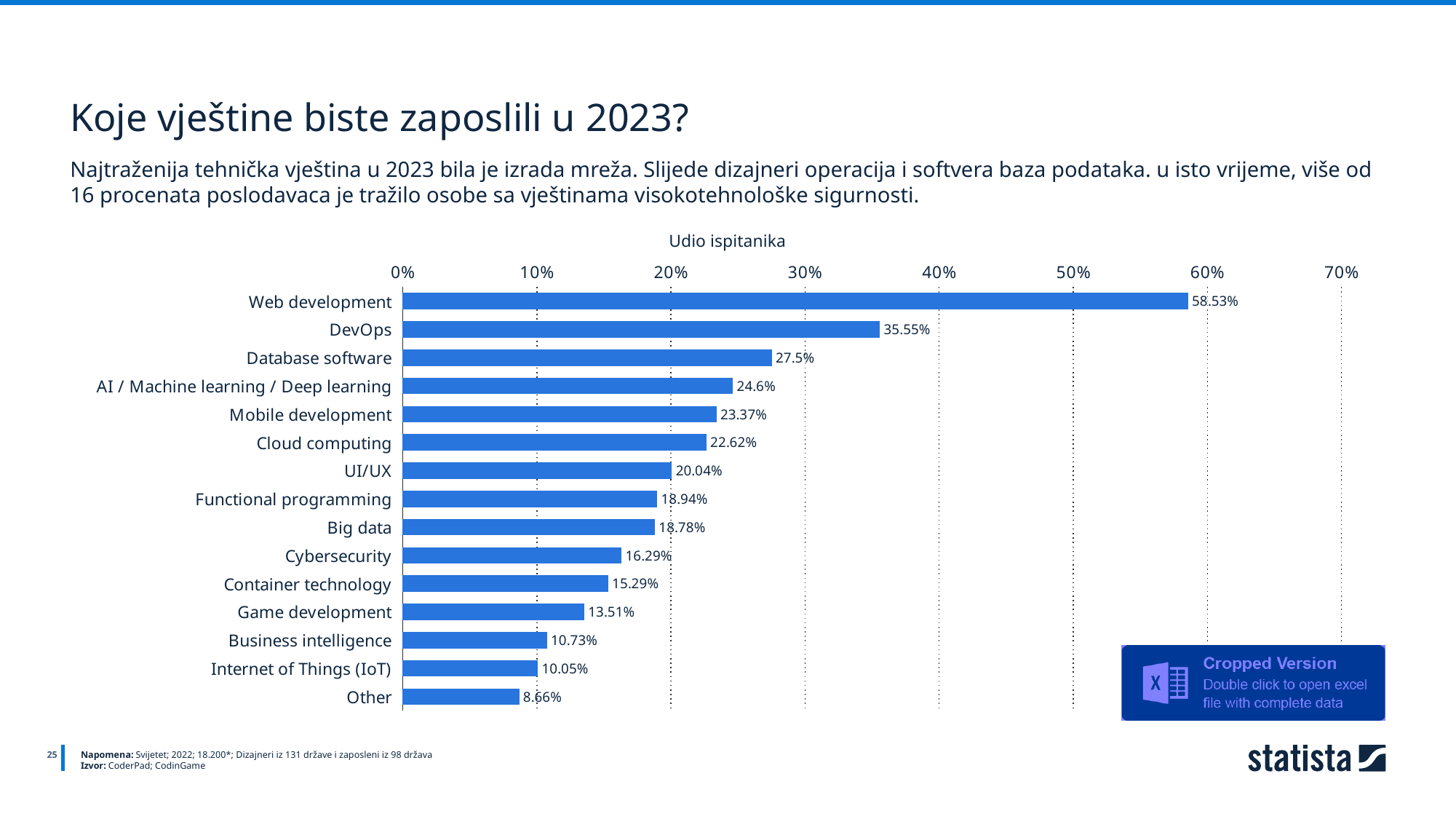
Which is larger, the value for Cloud computing or the value for UI/UX? Cloud computing What is the difference between the values for Web development and DevOps? 22.98% How many categories are shown in the chart? 15 What kind of chart is shown on the slide? bar chart Is the value for Database software greater or less than 30%? less What is the difference between the values for Game development and Business intelligence? 2.78% What is the value for Internet of Things (IoT)? 10.05% Which category has the highest value? Web development Which category has the lowest value? Other What is the value for Cybersecurity? 16.29% What is the value for Web development? 58.53% What is the title of the chart's axis shown above the bars? Udio ispitanika